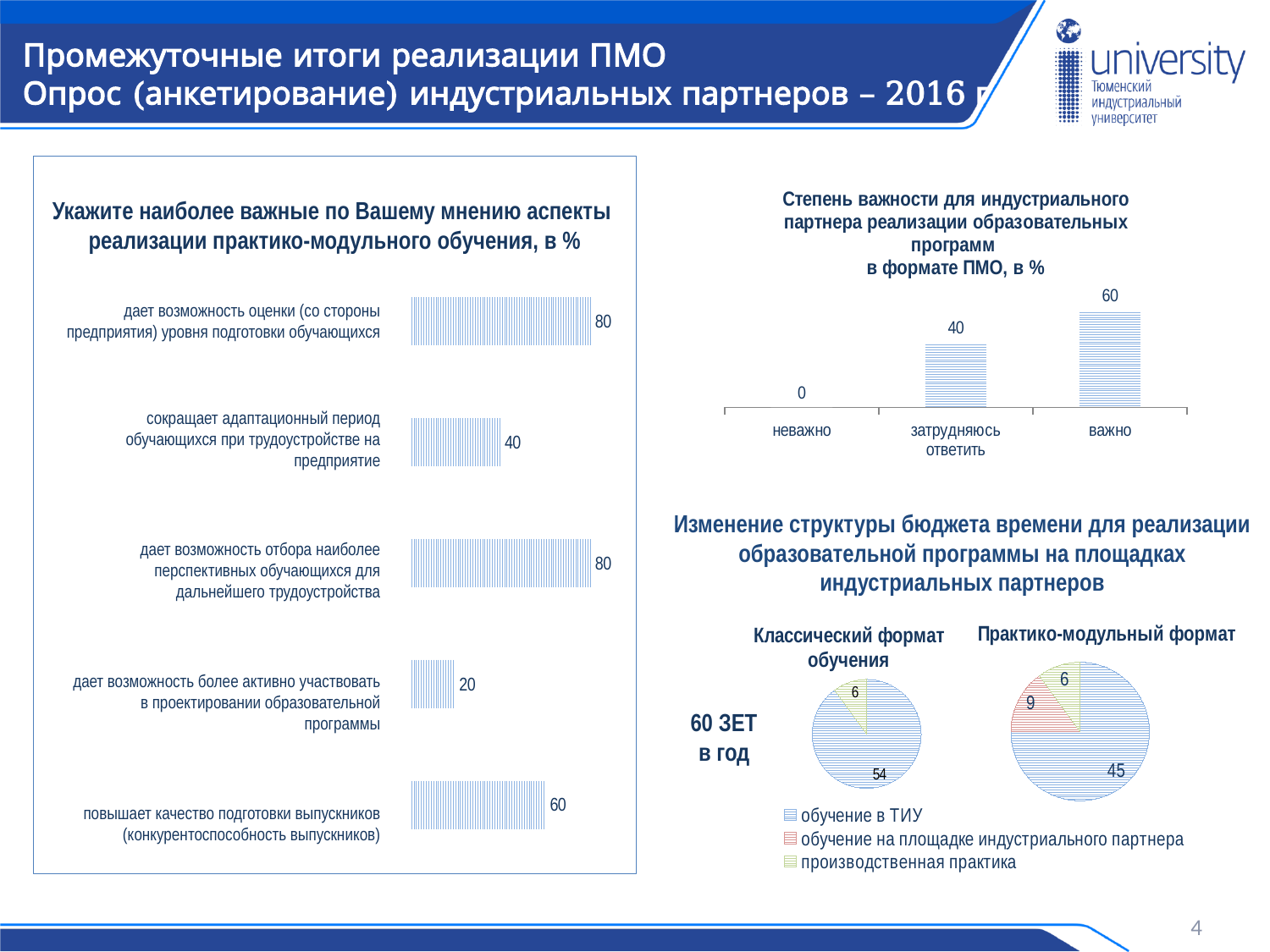
How many entries does the legend below the pie charts list? 3 On the left bar chart about the most important aspects of practice-modular training, how many categories are shown? 5 On the left bar chart about the most important aspects of practice-modular training, what is the difference between the value for 'дает возможность оценки (со стороны предприятия) уровня подготовки обучающихся' and the value for 'дает возможность более активно участвовать в проектировании образовательной программы'? 60 On the left bar chart about the most important aspects of practice-modular training, which category has the lowest value? дает возможность более активно участвовать в проектировании образовательной программы On the pie chart 'Практико-модульный формат', what is the value for 'обучение на площадке индустриального партнера'? 9 On the left bar chart 'Укажите наиболее важные по Вашему мнению аспекты реализации практико-модульного обучения, в %', what is the value for 'сокращает адаптационный период обучающихся при трудоустройстве на предприятие'? 40 On the chart 'Степень важности для индустриального партнера реализации образовательных программ в формате ПМО, в %', which category has the highest value? важно On the left bar chart about the most important aspects of practice-modular training, what is the value for 'повышает качество подготовки выпускников (конкурентоспособность выпускников)'? 60 What kind of chart is 'Степень важности для индустриального партнера реализации образовательных программ в формате ПМО, в %'? bar chart On the pie chart 'Классический формат обучения', what is the value for 'обучение в ТИУ'? 54 On the chart 'Степень важности для индустриального партнера реализации образовательных программ в формате ПМО, в %', what is the value for 'затрудняюсь ответить'? 40 On the chart 'Степень важности для индустриального партнера реализации образовательных программ в формате ПМО, в %', do the values rise or fall from left to right? rise